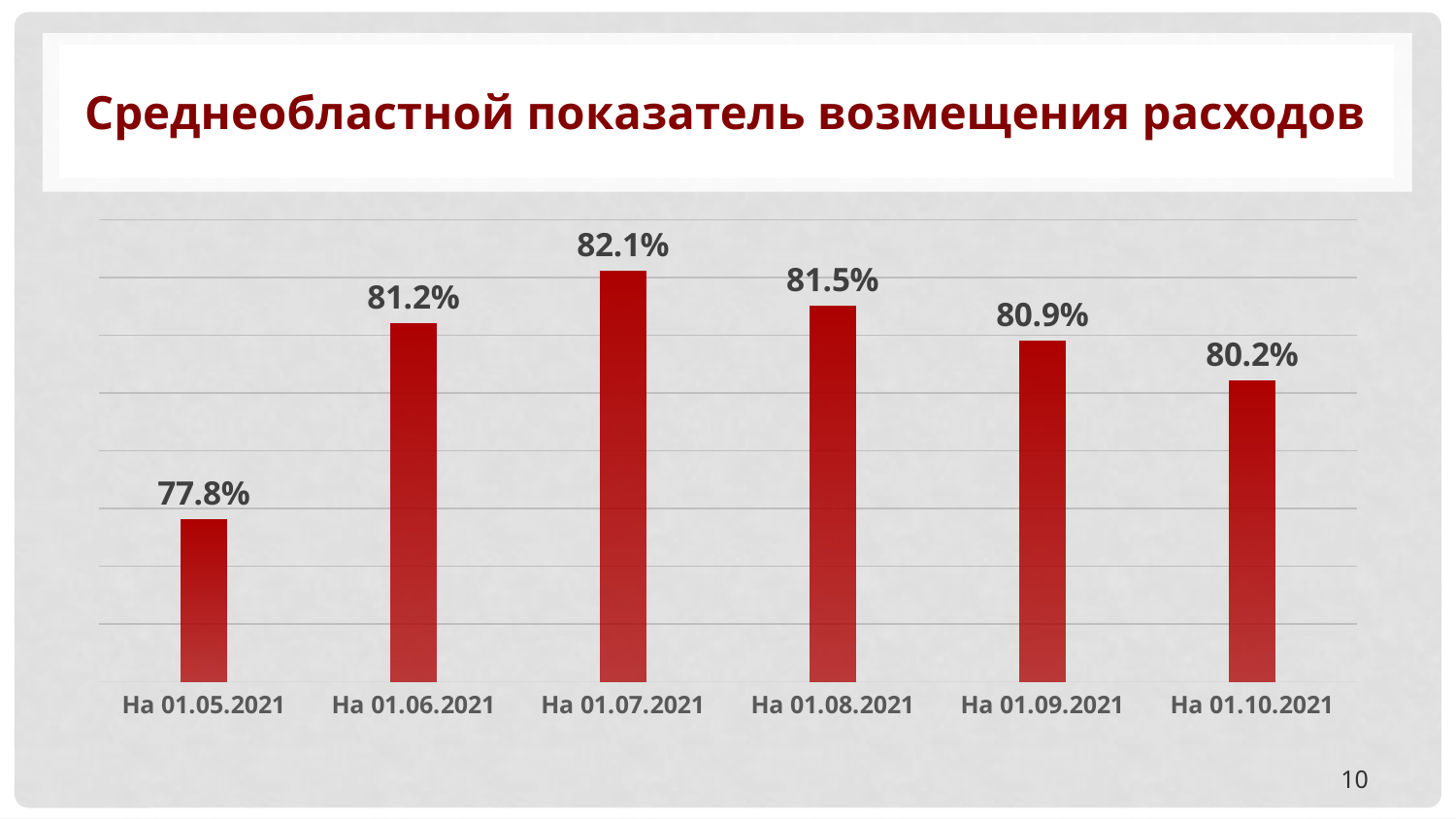
Which date has the lowest value? На 01.05.2021 What is the value for На 01.05.2021? 77.8% What is the title of the chart? Среднеобластной показатель возмещения расходов Which is larger, the value for На 01.06.2021 or the value for На 01.09.2021? На 01.06.2021 What is the difference between the values for На 01.07.2021 and На 01.05.2021? 4.3% What is the value for На 01.07.2021? 82.1% What is the difference between the values for На 01.06.2021 and На 01.08.2021? 0.3% What is the value for На 01.09.2021? 80.9% Which date has the highest value? На 01.07.2021 What is the value for На 01.10.2021? 80.2% How many dates are shown on the chart? 6 What kind of chart is shown on the slide? Bar chart